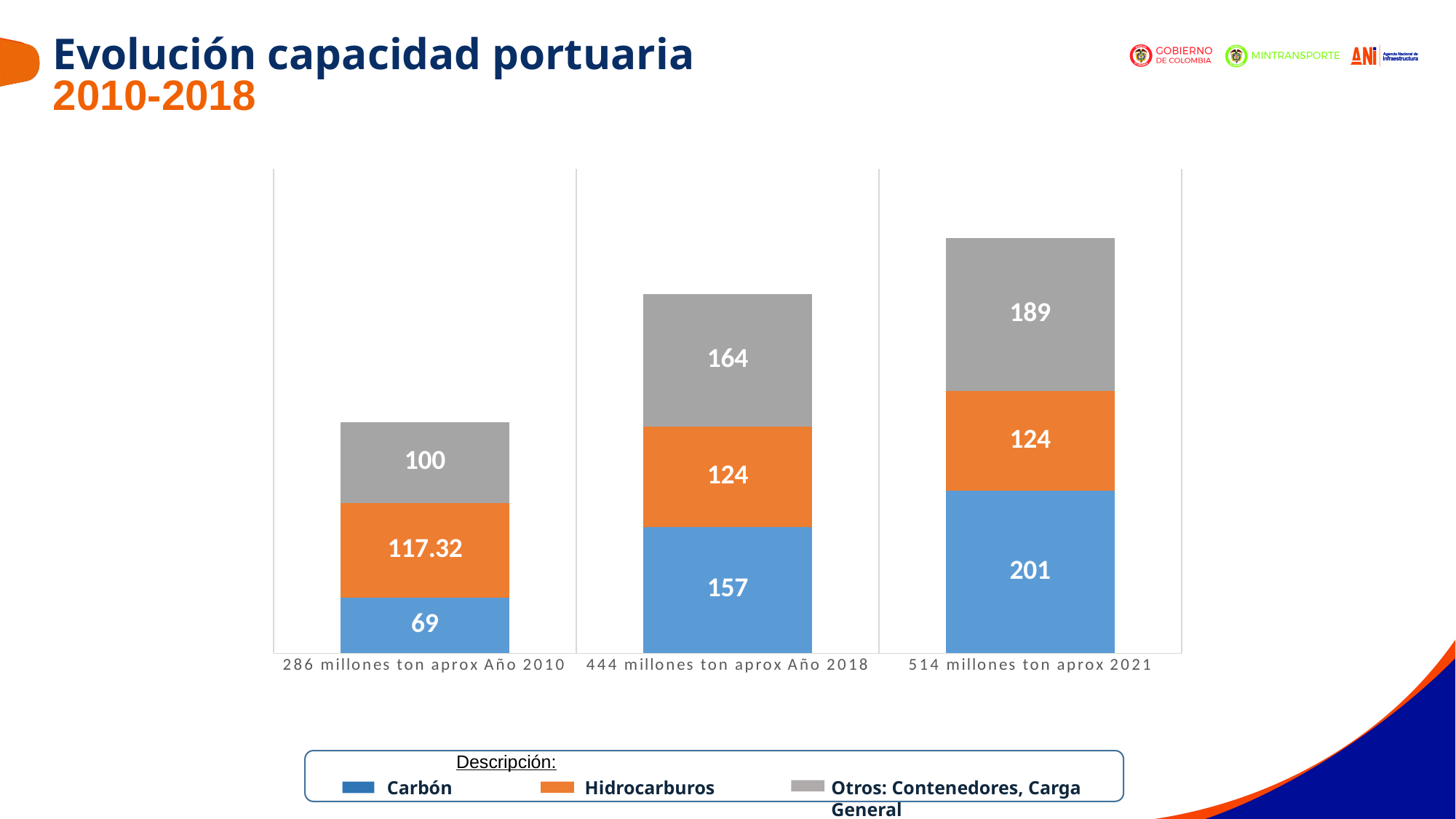
What is the difference between the Carbón values for 2021 and 2018? 44 Which bar has the highest Carbón value? 514 millones ton aprox 2021 What type of chart is shown on the slide? Stacked bar chart What is the Carbón value for the 2010 bar (286 millones ton aprox Año 2010)? 69 How many series does the legend list? 3 What is the Otros: Contenedores, Carga General value for the 2018 bar? 164 Is the Otros value larger for the 2021 bar or the 2018 bar? 2021 bar What is the total of the stacked bar for 2021 (201 + 124 + 189)? 514 What is the Hidrocarburos value for the 2010 bar? 117.32 What is the Carbón value for the 2021 bar (514 millones ton aprox 2021)? 201 How many bars (categories) are shown in the chart? 3 Which bar has the lowest Otros: Contenedores, Carga General value? 286 millones ton aprox Año 2010